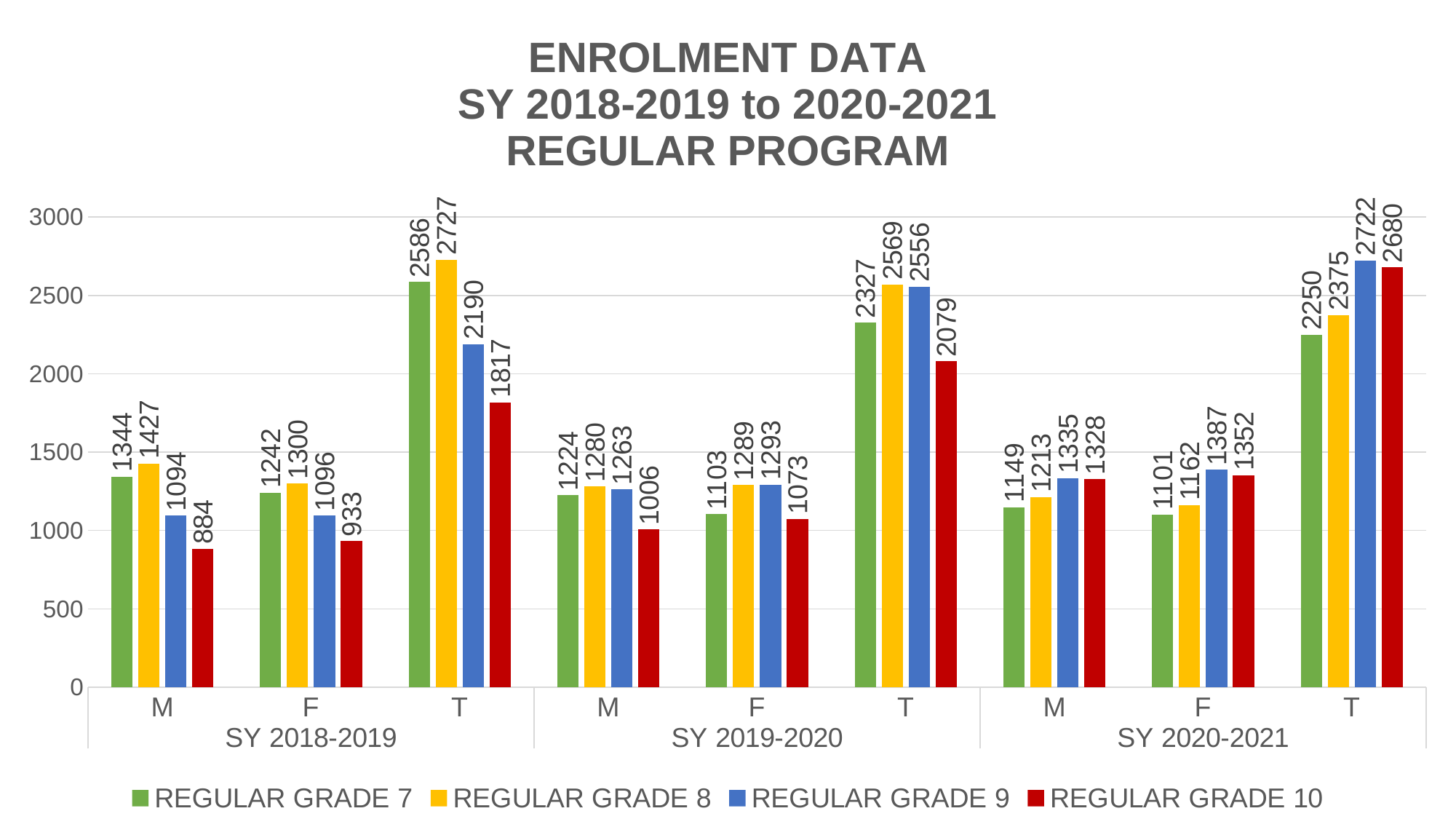
Is the value for REGULAR GRADE 10 for T in SY 2018-2019 greater or less than 2000? less What is the value for REGULAR GRADE 7 for M in SY 2018-2019? 1344 What kind of chart is shown on the slide? bar chart What is the difference between REGULAR GRADE 8 and REGULAR GRADE 10 for T in SY 2019-2020? 490 How many series does the legend list? 4 What is the title of the chart? ENROLMENT DATA SY 2018-2019 to 2020-2021 REGULAR PROGRAM What is the value for REGULAR GRADE 10 for T in SY 2020-2021? 2680 Which series has the highest value for T in SY 2018-2019? REGULAR GRADE 8 Which is larger for F in SY 2020-2021: REGULAR GRADE 9 or REGULAR GRADE 8? REGULAR GRADE 9 Which series has the lowest value for M in SY 2018-2019? REGULAR GRADE 10 How does the REGULAR GRADE 10 value for T change from SY 2018-2019 to SY 2020-2021? rises What is the value for REGULAR GRADE 9 for F in SY 2019-2020? 1293